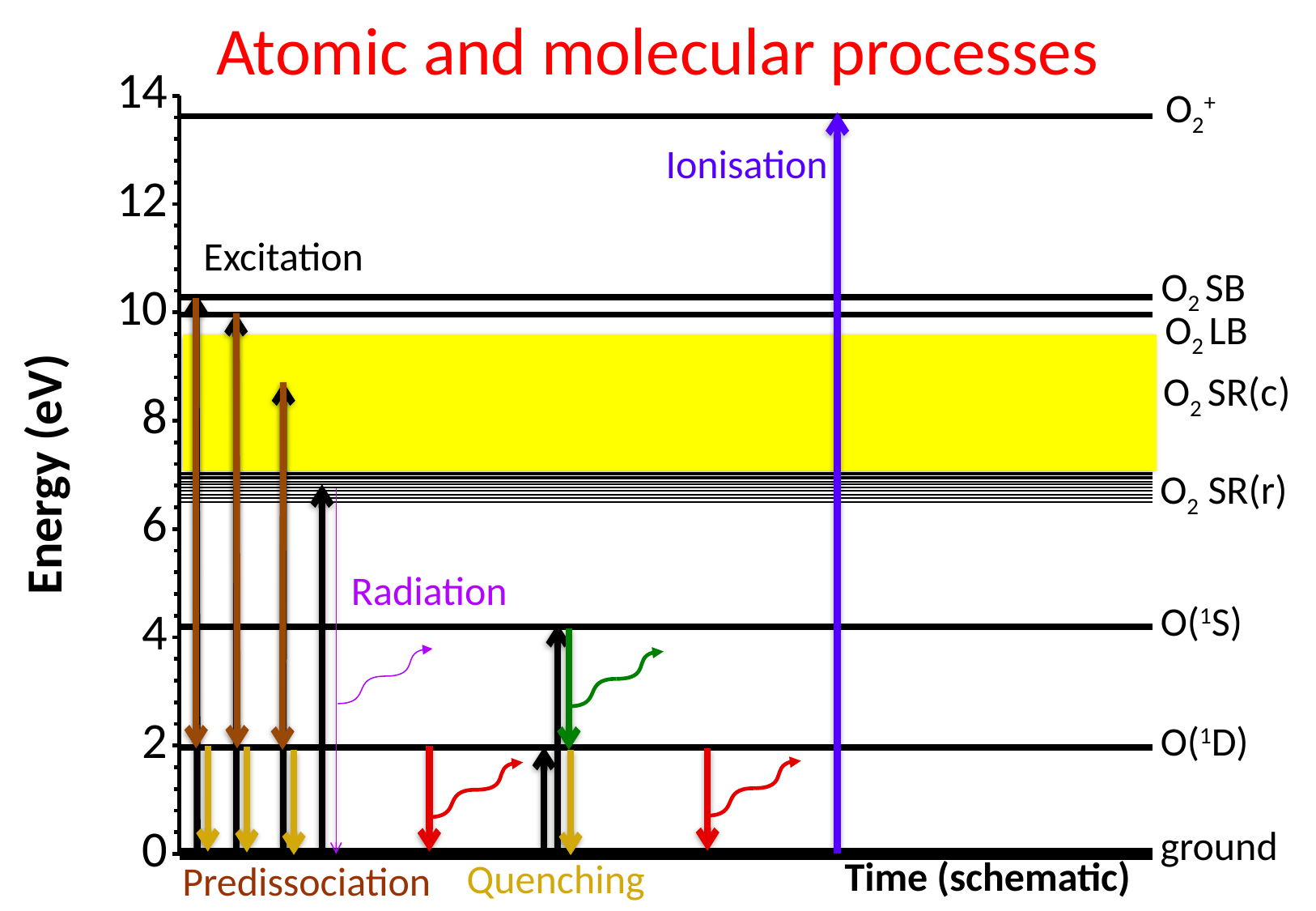
Is the energy of the O2 SB level greater or less than 10 eV? greater Is the energy of the O(1D) level greater or less than 4 eV? less How many energy levels are labeled on the right side of the chart? 8 Which level has the higher energy, O(1S) or O(1D)? O(1S) What kind of chart is shown on the slide? energy level diagram Which labeled energy level is the highest? O2+ What is the label on the vertical axis? Energy (eV) What is the energy of the ground level in eV? 0 Is the energy of the O(1S) level greater or less than 6 eV? less Which labeled energy level is the lowest? ground What is the title of the chart? Atomic and molecular processes